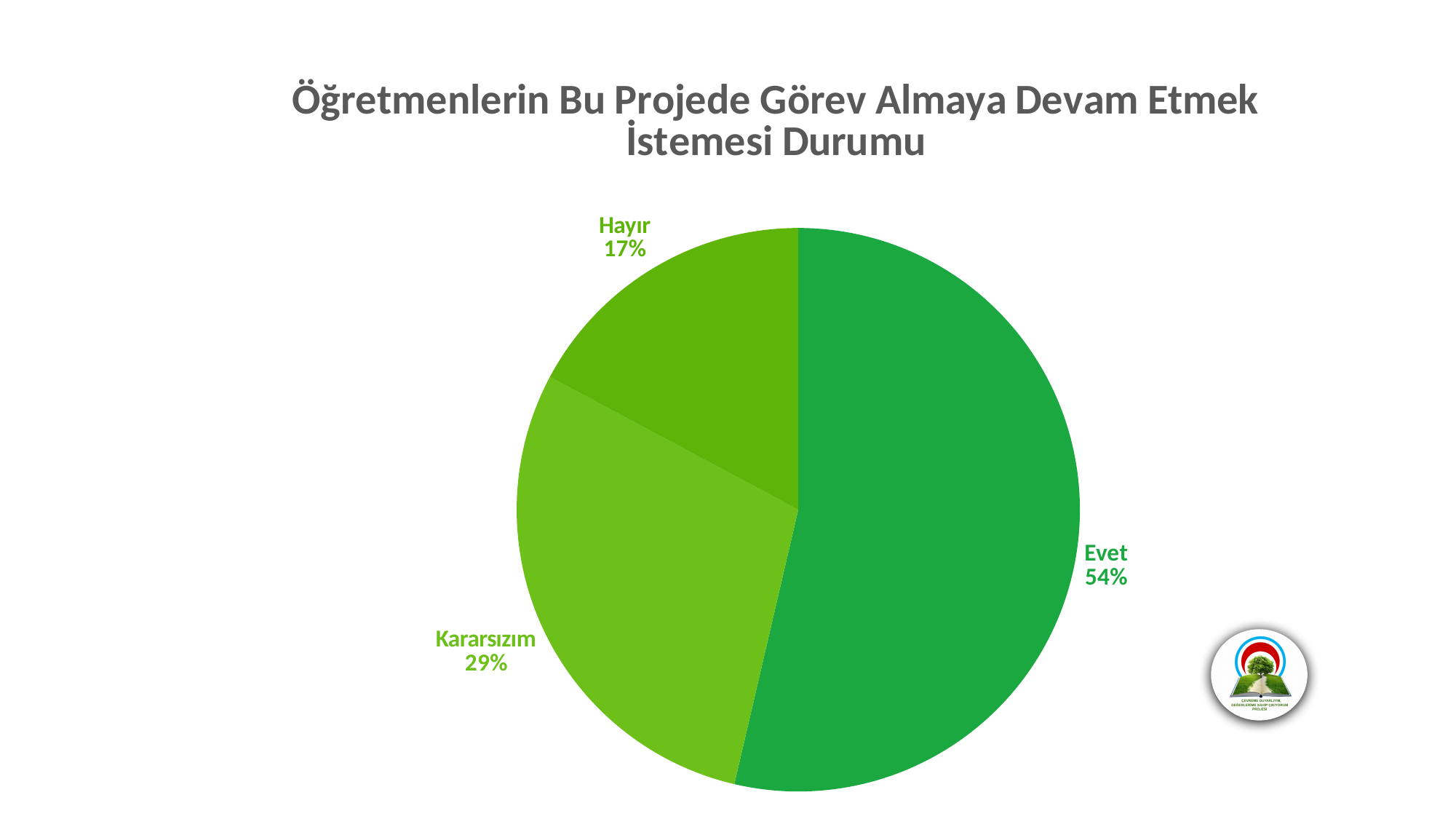
Which category has the smallest share of the pie? Hayır What share of the pie does the Evet slice represent? 54% What is the difference in percentage points between the Evet and Kararsızım slices? 25 What is the difference in percentage points between the Kararsızım and Hayır slices? 12 How many slices does the pie chart have? 3 What is the title of the chart? Öğretmenlerin Bu Projede Görev Almaya Devam Etmek İstemesi Durumu Is the share for Evet greater or less than 50%? greater What share of the pie does the Kararsızım slice represent? 29% What kind of chart is shown on the slide? Pie chart What share of the pie does the Hayır slice represent? 17% Which is larger, the Kararsızım slice or the Hayır slice? Kararsızım Which category has the largest share of the pie? Evet